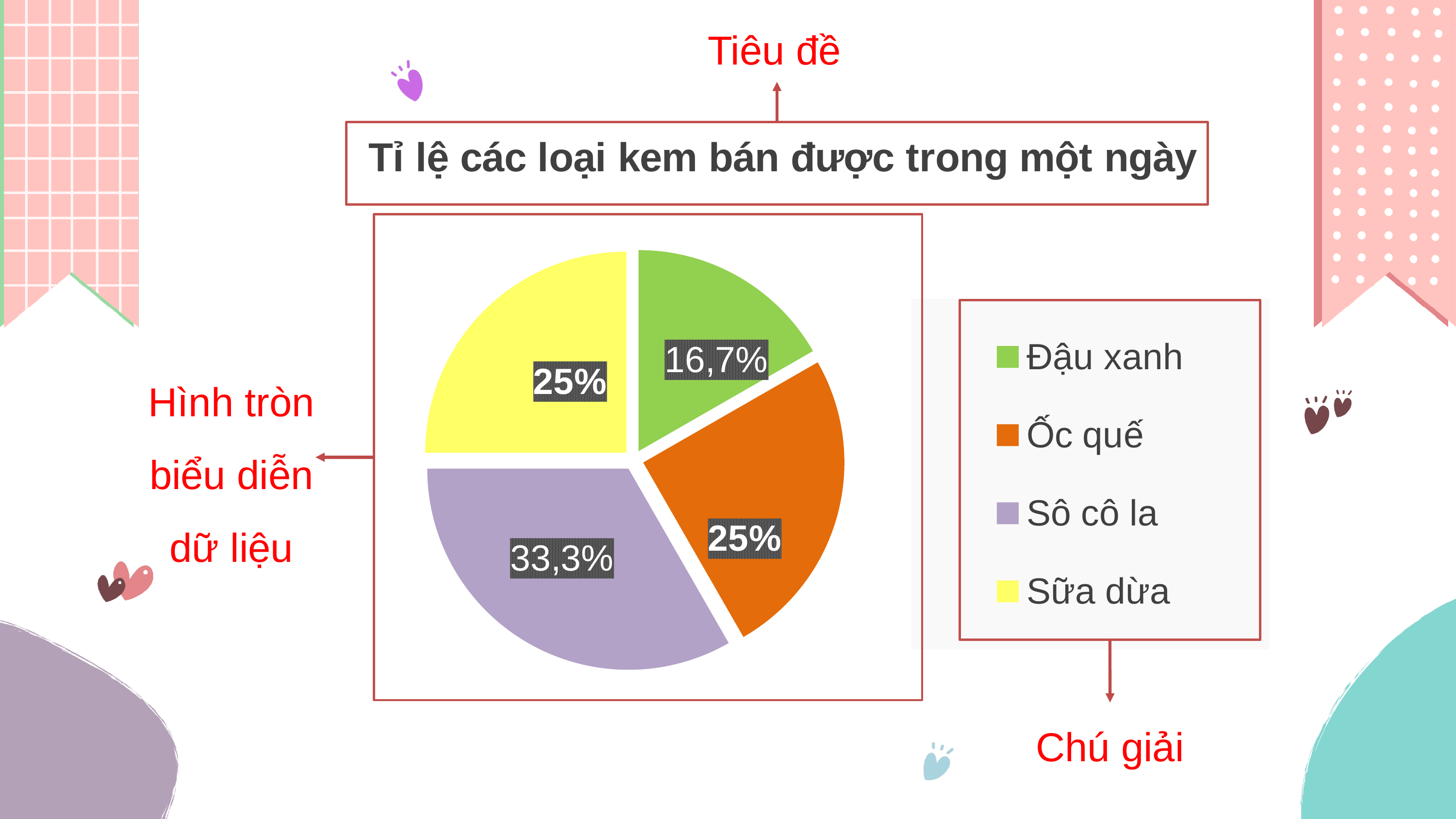
What share of the pie does Sữa dừa have? 25% Which category has the largest slice of the pie? Sô cô la What share of the pie does Đậu xanh have? 16,7% What share of the pie does Ốc quế have? 25% Which category has the smallest slice of the pie? Đậu xanh Which is larger, the share for Sô cô la or the share for Ốc quế? Sô cô la What is the title of the chart? Tỉ lệ các loại kem bán được trong một ngày What type of chart is shown on the slide? pie chart How many categories are shown in the pie chart? 4 What share of the pie does Sô cô la have? 33,3% Which colour represents Sữa dừa in the legend? yellow What is the difference between the share for Sô cô la and the share for Đậu xanh? 16,6%